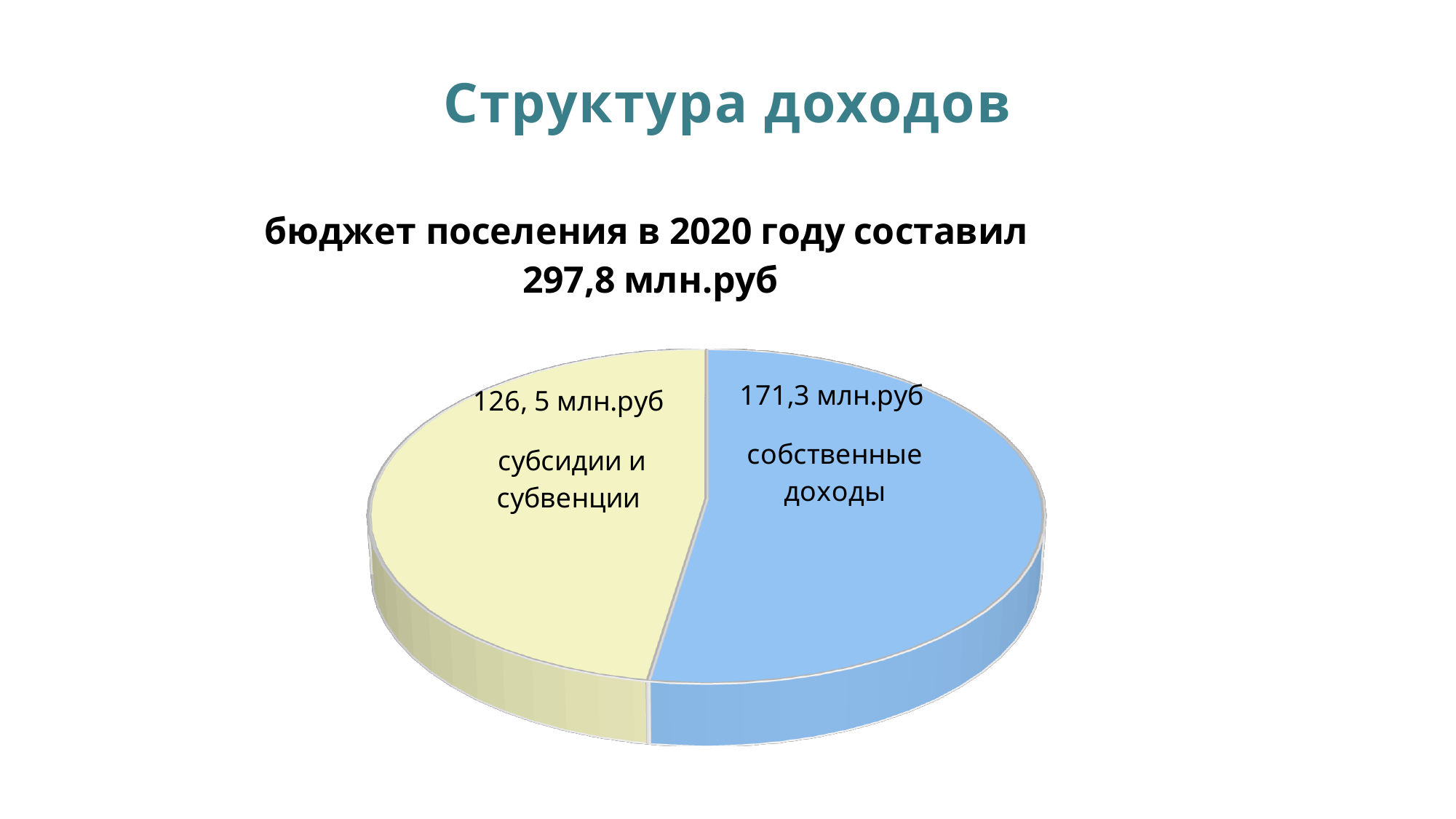
What is the value for собственные доходы? 171,3 млн.руб What is the difference between собственные доходы and субсидии и субвенции? 44,8 млн.руб What colour is the собственные доходы slice? blue What kind of chart is shown on the slide? pie chart What is the value for субсидии и субвенции? 126, 5 млн.руб Which slice of the pie is the largest? собственные доходы How many slices does the pie chart have? 2 Which slice of the pie is the smallest? субсидии и субвенции What is the title of the slide? Структура доходов Which is larger: собственные доходы or субсидии и субвенции? собственные доходы What is the total budget of the settlement in 2020 according to the slide? 297,8 млн.руб What share of the total budget do собственные доходы make up? 57,5%